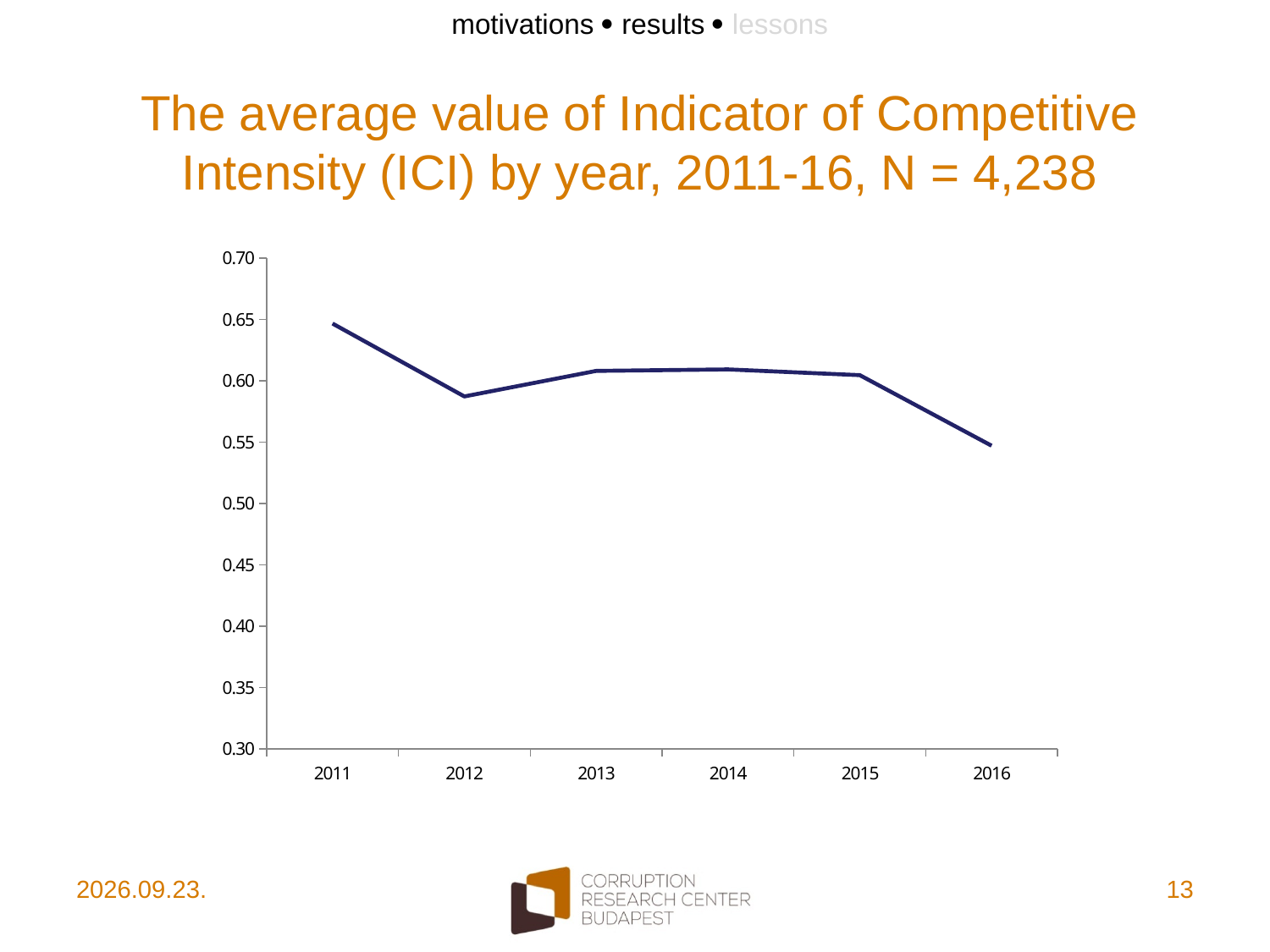
Is the value for 2012 greater or less than 0.60? less Which year has the larger average ICI value, 2015 or 2016? 2015 Which year has the larger average ICI value, 2011 or 2012? 2011 How many years are plotted on the x axis? 6 Is the value for 2014 greater or less than 0.55? greater Which year has the highest average ICI value? 2011 Is the value for 2011 greater or less than 0.60? greater What is the sample size (N) stated in the chart title? 4,238 Which year has the lowest average ICI value? 2016 Overall, does the average ICI value rise or fall from 2011 to 2016? fall What kind of chart is shown on the slide? line chart